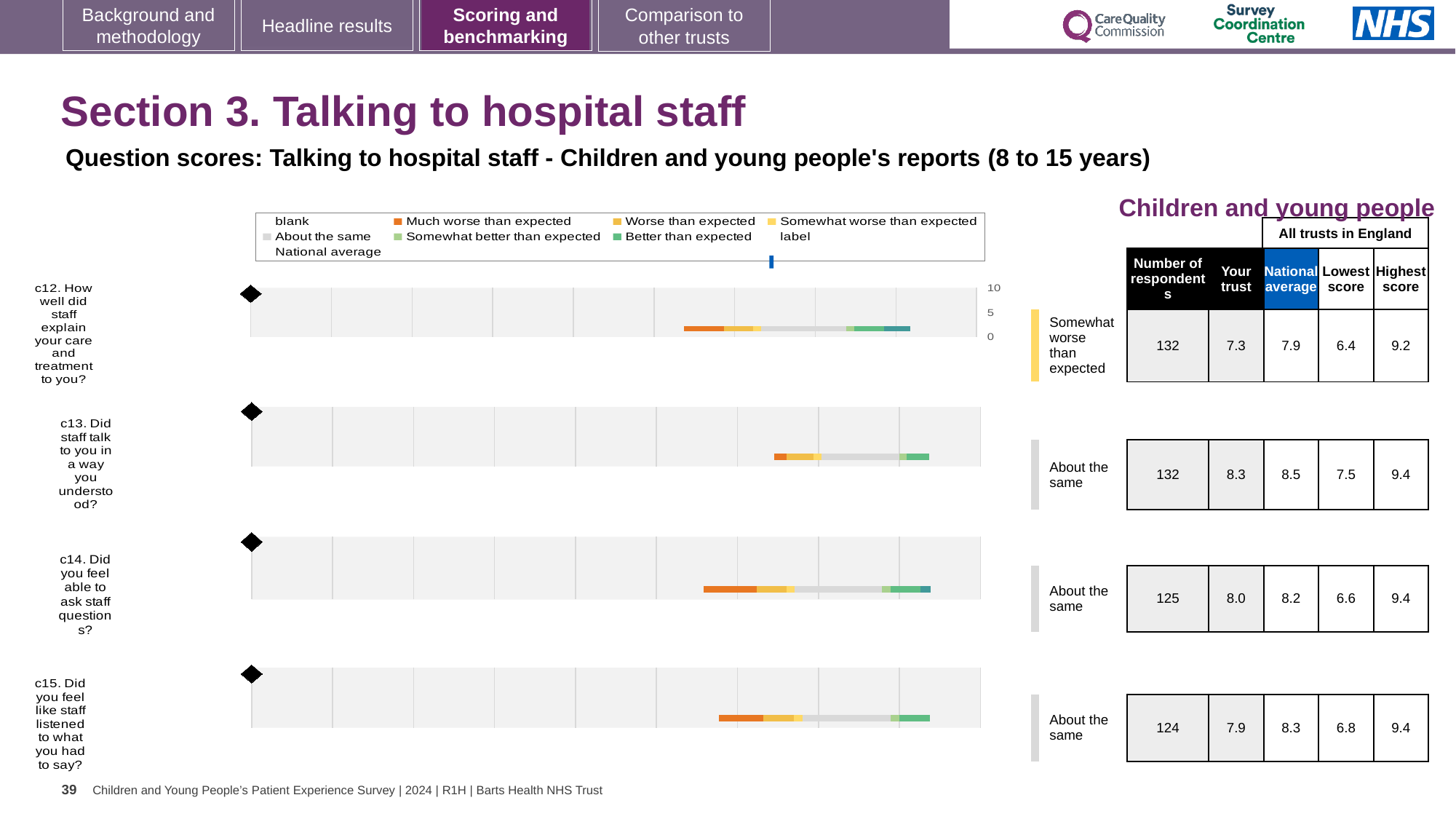
What is the 'Your trust' score for c12 (How well did staff explain your care and treatment to you?)? 7.3 How many questions are charted on the slide? 4 What is the national average score for c13 (Did staff talk to you in a way you understood?)? 8.5 Which question has the highest 'Your trust' score? c13 Which benchmark category is c12 rated as? Somewhat worse than expected Which has the larger 'Your trust' score, c14 or c12? c14 What is the lowest score among all trusts in England for c12? 6.4 Which question has the lowest 'Your trust' score? c12 How many respondents answered c14 (Did you feel able to ask staff questions?)? 125 What is the difference between the national average and the 'Your trust' score for c15? 0.4 What kind of chart is used to show each question's score? Bar chart What is the highest score among all trusts in England for c15 (Did you feel like staff listened to what you had to say?)? 9.4